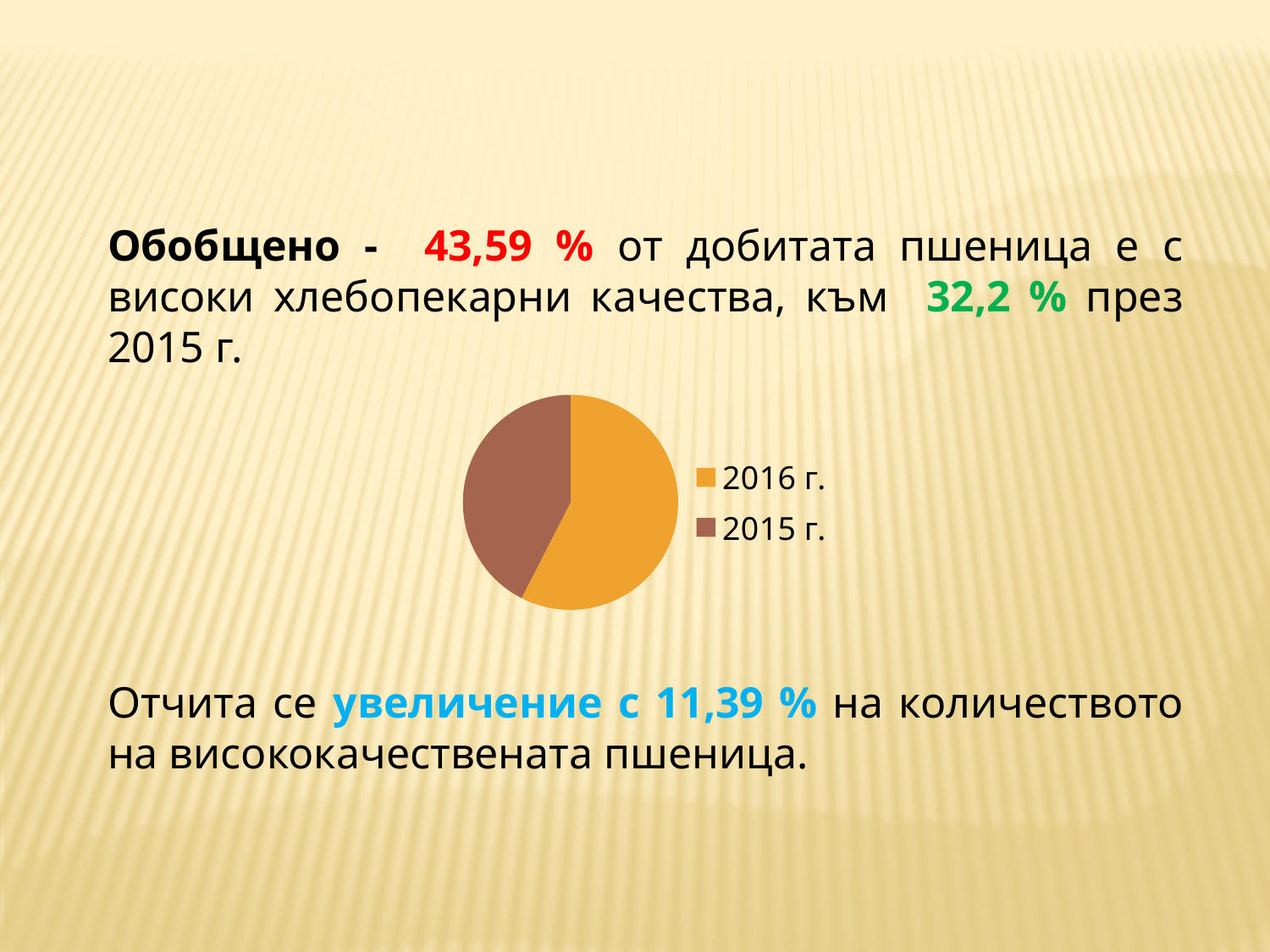
What colour is the slice for 2015 г. in the pie chart? brown What colour is the slice for 2016 г. in the pie chart? orange Which slice of the pie chart is the largest? 2016 г. How many entries does the legend of the pie chart list? 2 Which slice of the pie chart is the smallest? 2015 г. In the pie chart, which slice is larger: 2016 г. or 2015 г.? 2016 г. What kind of chart is shown on the slide? pie chart Does the slice for 2015 г. take up more or less than half of the pie chart? less Does the slice for 2016 г. take up more or less than half of the pie chart? more How many slices does the pie chart have? 2